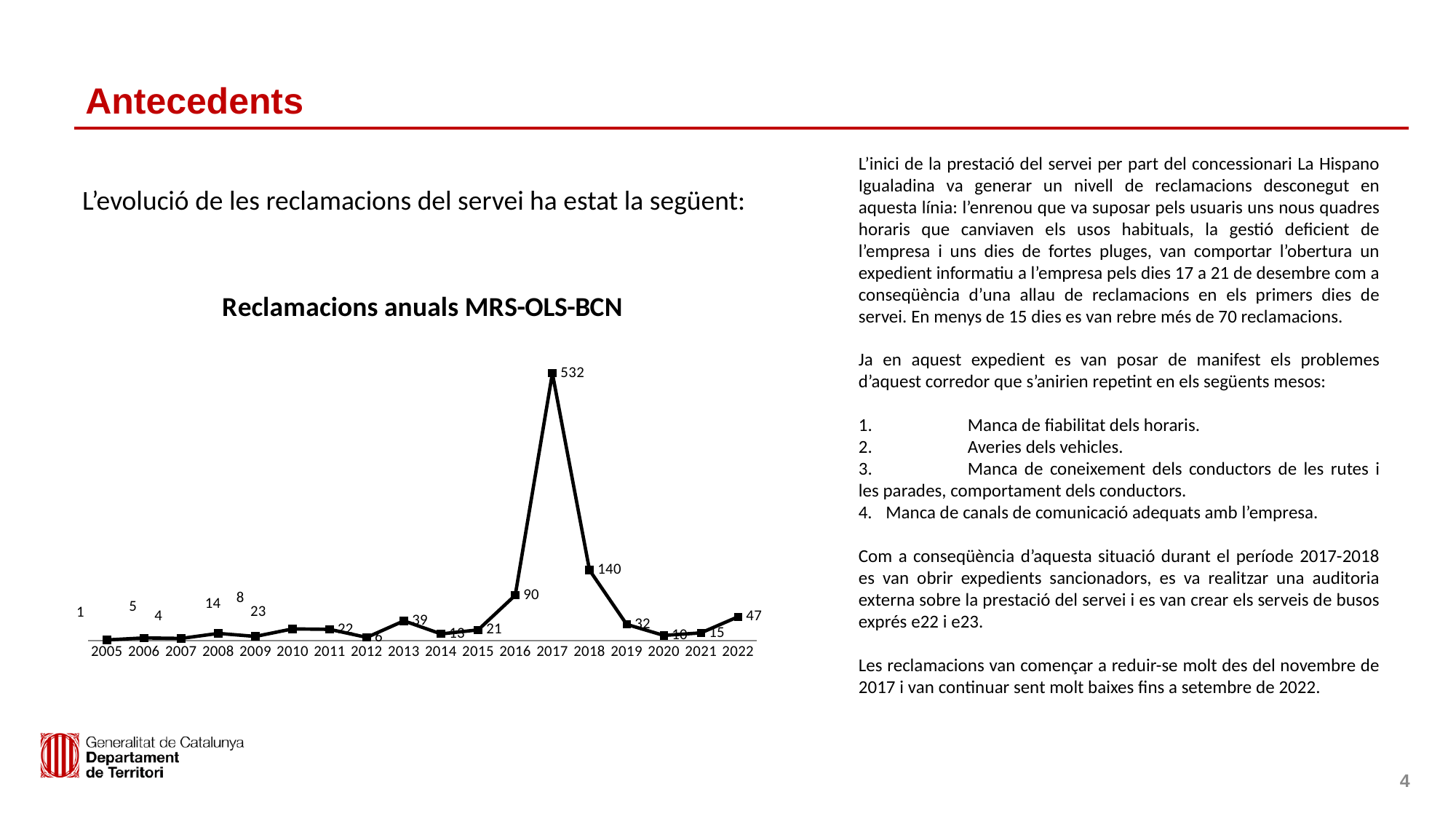
Which year has the lowest number of reclamacions? 2005 What kind of chart is shown on the slide? line chart How many years are plotted on the x axis of the chart? 18 What is the value for 2022? 47 What is the title of the chart? Reclamacions anuals MRS-OLS-BCN What is the value for 2018? 140 What is the difference between the values for 2017 and 2018? 392 Which year has the highest number of reclamacions? 2017 What is the value for 2017? 532 Which year has a larger value, 2016 or 2018? 2018 Do the values rise or fall from 2017 to 2020? fall What is the value for 2016? 90